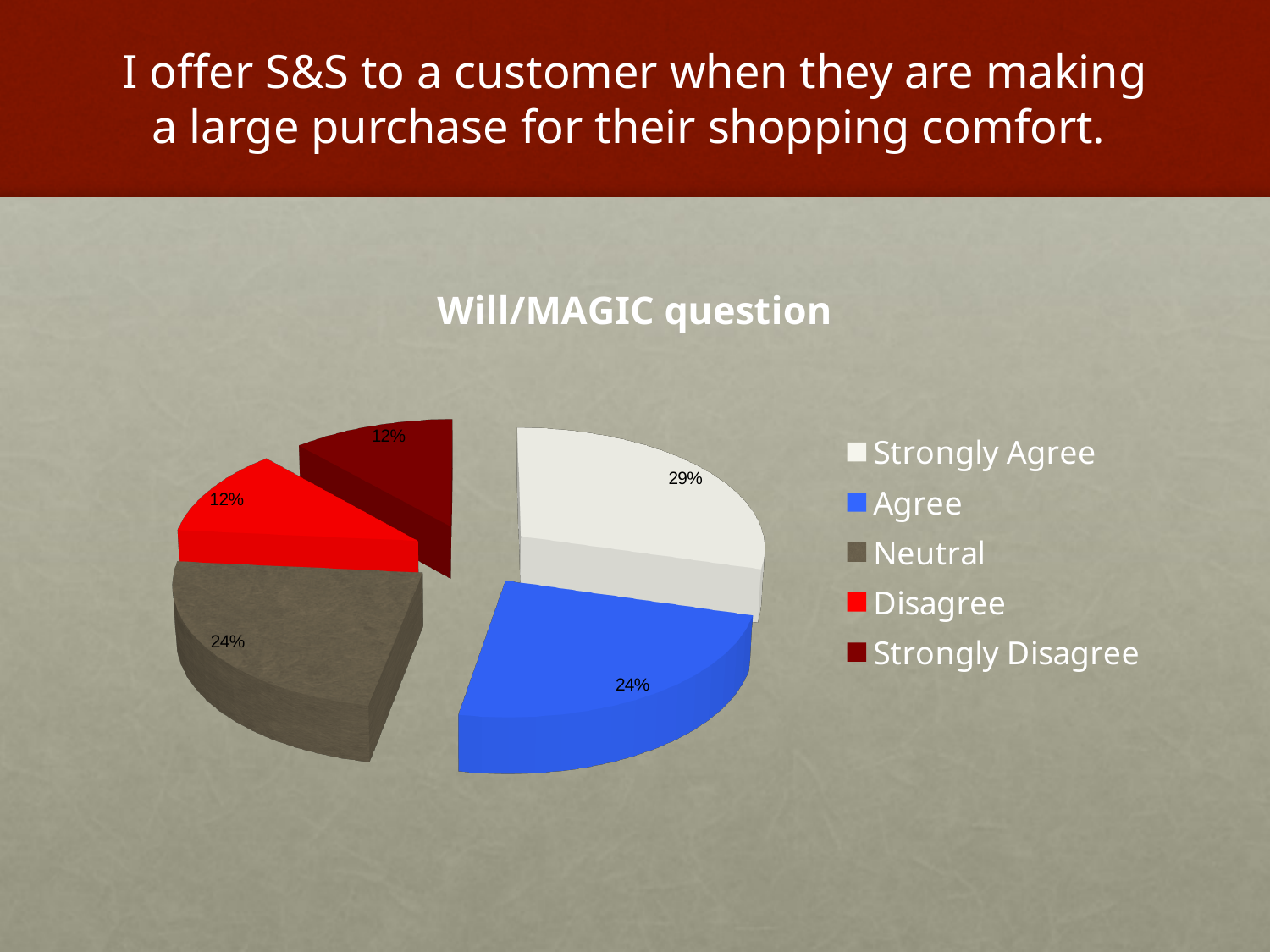
What is the title of the chart? Will/MAGIC question What is the difference in percentage points between Strongly Agree and Strongly Disagree? 17 percentage points What colour is the Agree slice? blue What type of chart is shown on the slide? pie chart What percentage of responses is Agree? 24% How many categories does the legend list? 5 What percentage of responses is Strongly Disagree? 12% What percentage of responses is Neutral? 24% Which category has the largest share of the pie? Strongly Agree What percentage of responses is Strongly Agree? 29% How many slices does the pie chart have? 5 Which is larger, the share for Strongly Agree or the share for Disagree? Strongly Agree